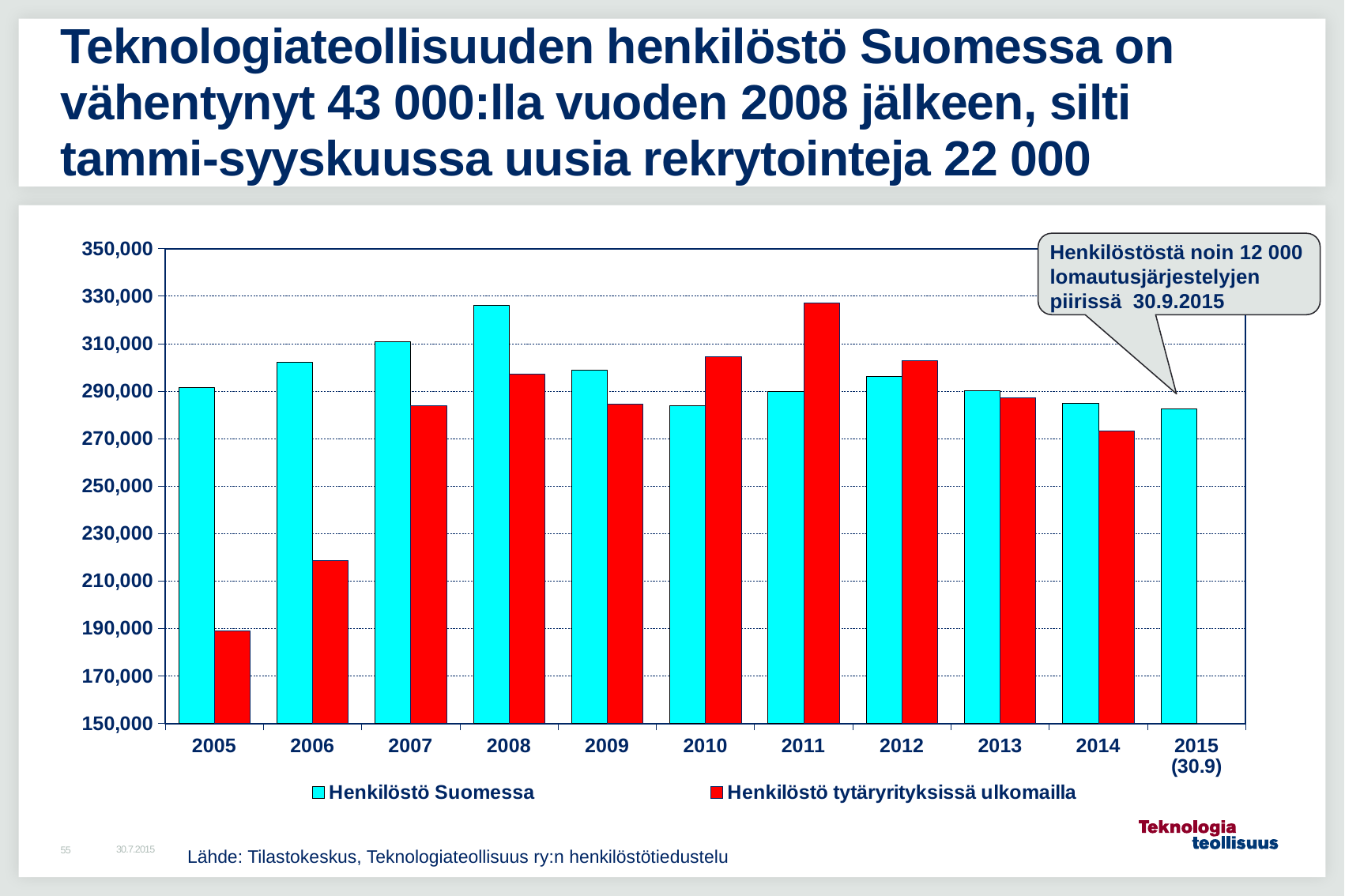
Is the value for Henkilöstö tytäryrityksissä ulkomailla in 2014 greater or less than 290,000? less How many years (categories) are shown on the x axis? 11 How many series does the legend list? 2 In which year is the value for Henkilöstö tytäryrityksissä ulkomailla highest? 2011 In which year is the value for Henkilöstö Suomessa highest? 2008 Is the value for Henkilöstö Suomessa in 2008 greater or less than 310,000? greater What kind of chart is shown on the slide? bar chart In 2011, which series has the larger value: Henkilöstö Suomessa or Henkilöstö tytäryrityksissä ulkomailla? Henkilöstö tytäryrityksissä ulkomailla In 2005, which series has the larger value: Henkilöstö Suomessa or Henkilöstö tytäryrityksissä ulkomailla? Henkilöstö Suomessa Does the value for Henkilöstö Suomessa rise or fall from 2008 to 2015 (30.9)? fall In which year is the value for Henkilöstö tytäryrityksissä ulkomailla lowest? 2005 Is the value for Henkilöstö tytäryrityksissä ulkomailla in 2005 greater or less than 210,000? less